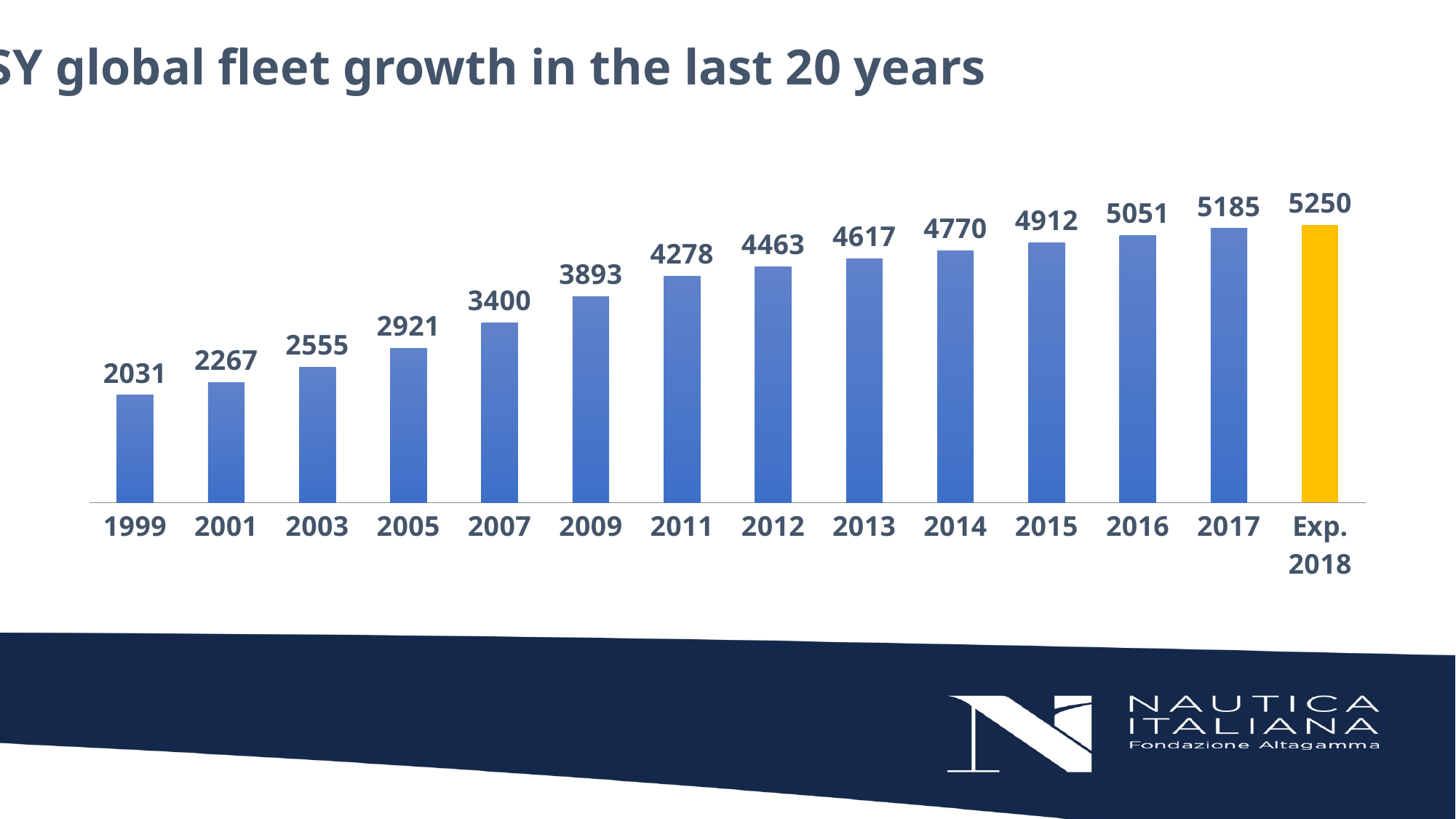
How many bars are shown in the chart? 14 What is the value for 2017? 5185 Do the values rise or fall from 1999 to Exp. 2018? Rise What kind of chart is shown on the slide? Bar chart Which is larger, the value for 2011 or the value for 2013? 2013 Which year has the lowest value? 1999 What is the value for 2009? 3893 What is the value for 1999? 2031 What is the difference between the values for 2017 and 2016? 134 Which category has the highest value? Exp. 2018 What is the expected value for 2018? 5250 What is the difference between the values for 2007 and 1999? 1369